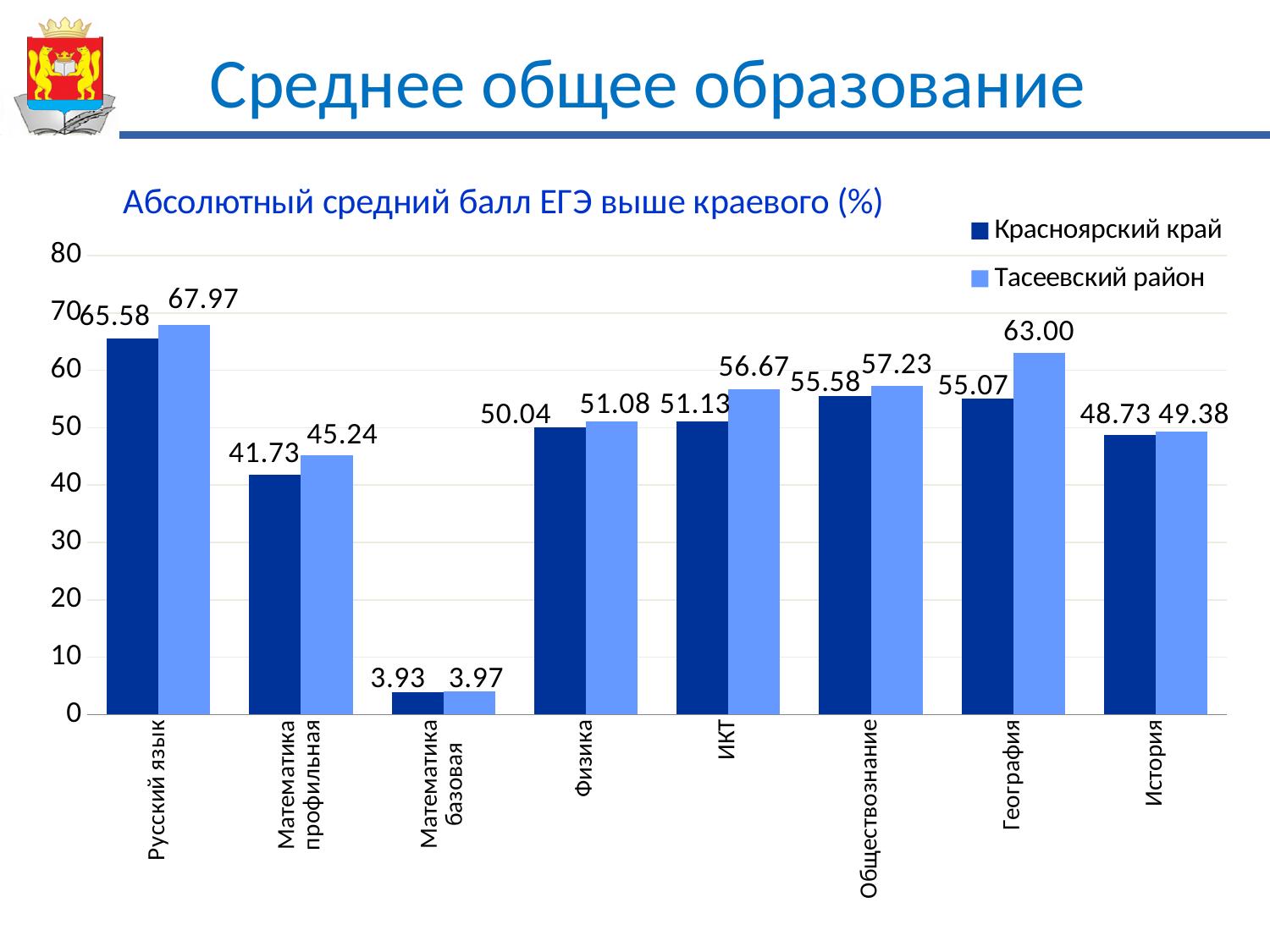
How many categories are shown on the x axis? 8 What is the value for Тасеевский район in ИКТ? 56.67 Which is larger in Математика профильная: Красноярский край or Тасеевский район? Тасеевский район Which category has the highest value for Тасеевский район? Русский язык What kind of chart is shown on the slide? bar chart Is the value for Красноярский край in История greater or less than 50? less What is the difference between Тасеевский район and Красноярский край in География? 7.93 Which category has the lowest value for Красноярский край? Математика базовая How many series does the legend list? 2 What is the value for Тасеевский район in География? 63.00 What is the title of the chart? Абсолютный средний балл ЕГЭ выше краевого (%) What is the value for Красноярский край in Русский язык? 65.58